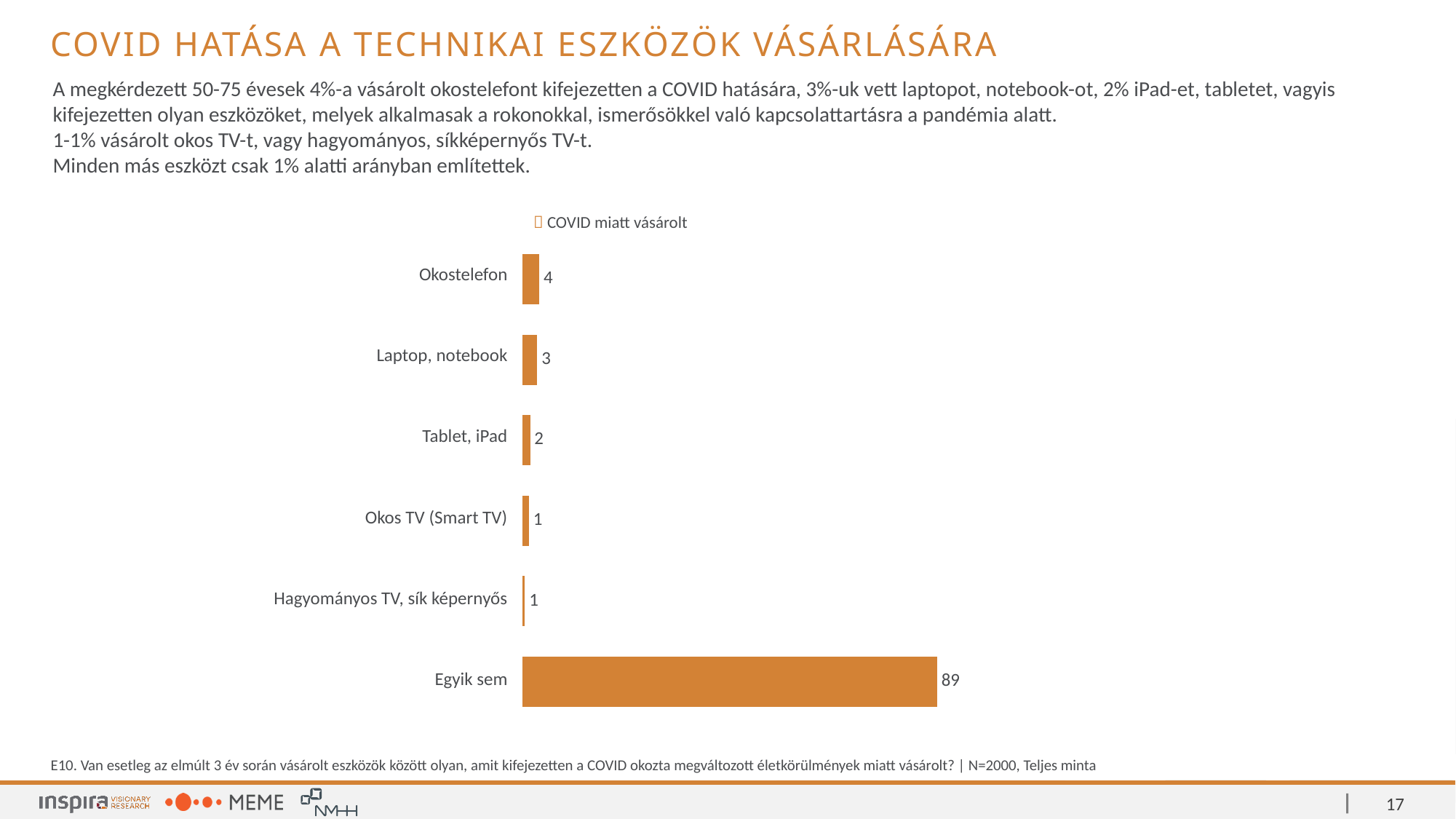
How many series does the legend list? 1 Which is larger, the value for Laptop, notebook or the value for Okos TV (Smart TV)? Laptop, notebook What is the difference between the values for Okostelefon and Tablet, iPad? 2 What is the value for Egyik sem? 89 What is the legend entry of the chart? COVID miatt vásárolt What is the difference between the values for Egyik sem and Okostelefon? 85 Which category has the highest value? Egyik sem What is the value for Tablet, iPad? 2 What is the value for Okostelefon? 4 How many categories are shown in the chart? 6 What kind of chart is shown on the slide? bar chart What is the value for Laptop, notebook? 3